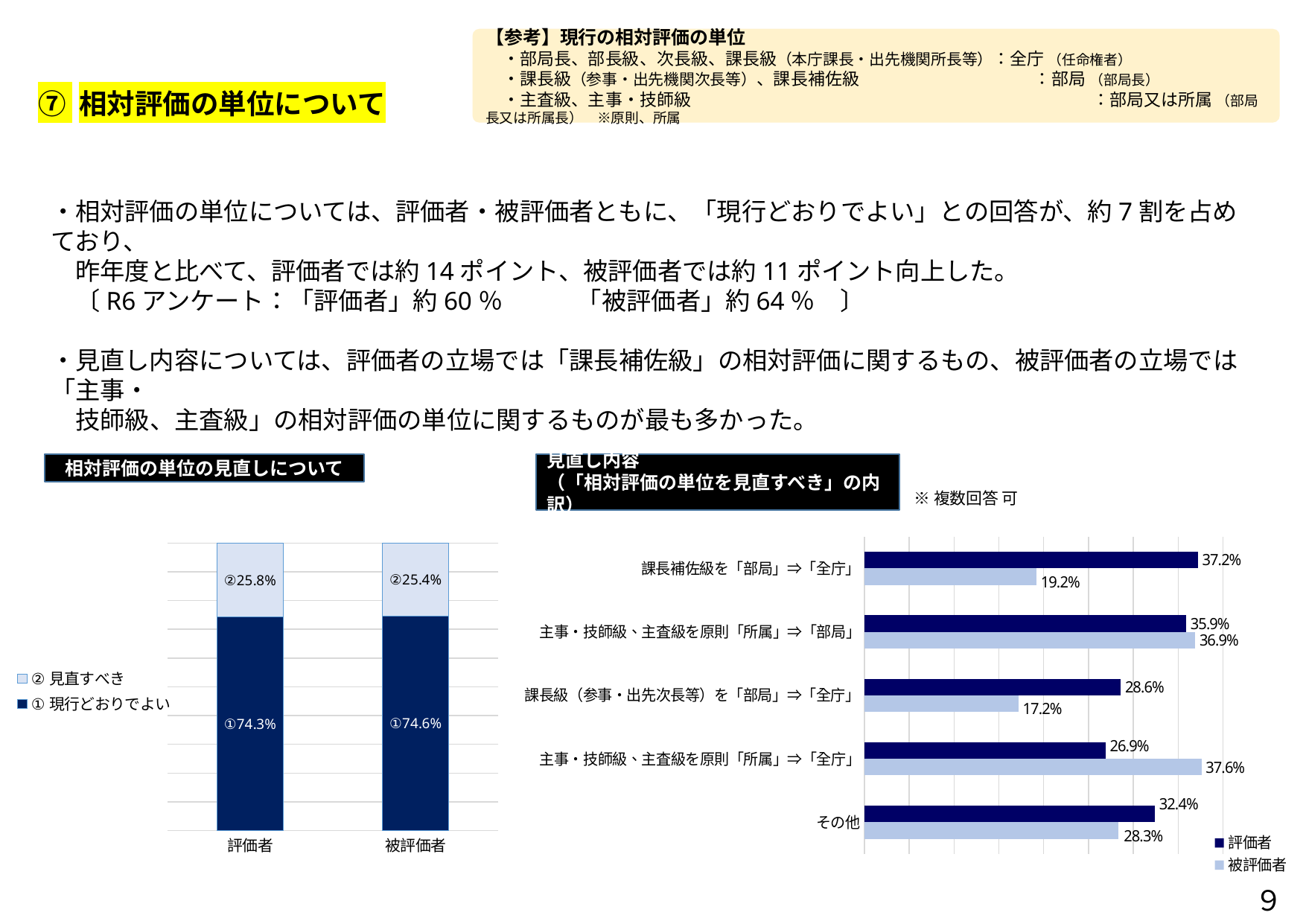
In the right chart (見直し内容), which category has the lowest 被評価者 value? 課長級（参事・出先次長等）を「部局」⇒「全庁」 In the right chart (見直し内容), what is the difference between the 評価者 and 被評価者 values for 課長補佐級を「部局」⇒「全庁」? 18.0% In the right chart (見直し内容), which colour represents 被評価者? light blue In the right chart (見直し内容), for その他, which is larger: the 評価者 value or the 被評価者 value? 評価者 In the left chart (相対評価の単位の見直しについて), what type of chart is shown? stacked bar chart In the right chart (見直し内容), which category has the highest 評価者 value? 課長補佐級を「部局」⇒「全庁」 In the left chart (相対評価の単位の見直しについて), what percentage of 被評価者 answered ② 見直すべき? 25.4% In the right chart (見直し内容), what is the 被評価者 value for 主事・技師級、主査級を原則「所属」⇒「全庁」? 37.6% In the right chart (見直し内容), how many categories are plotted? 5 In the left chart (相対評価の単位の見直しについて), how many series does the legend list? 2 In the left chart (相対評価の単位の見直しについて), what percentage of 評価者 answered ① 現行どおりでよい? 74.3% In the right chart (見直し内容), what is the 評価者 value for 課長補佐級を「部局」⇒「全庁」? 37.2%